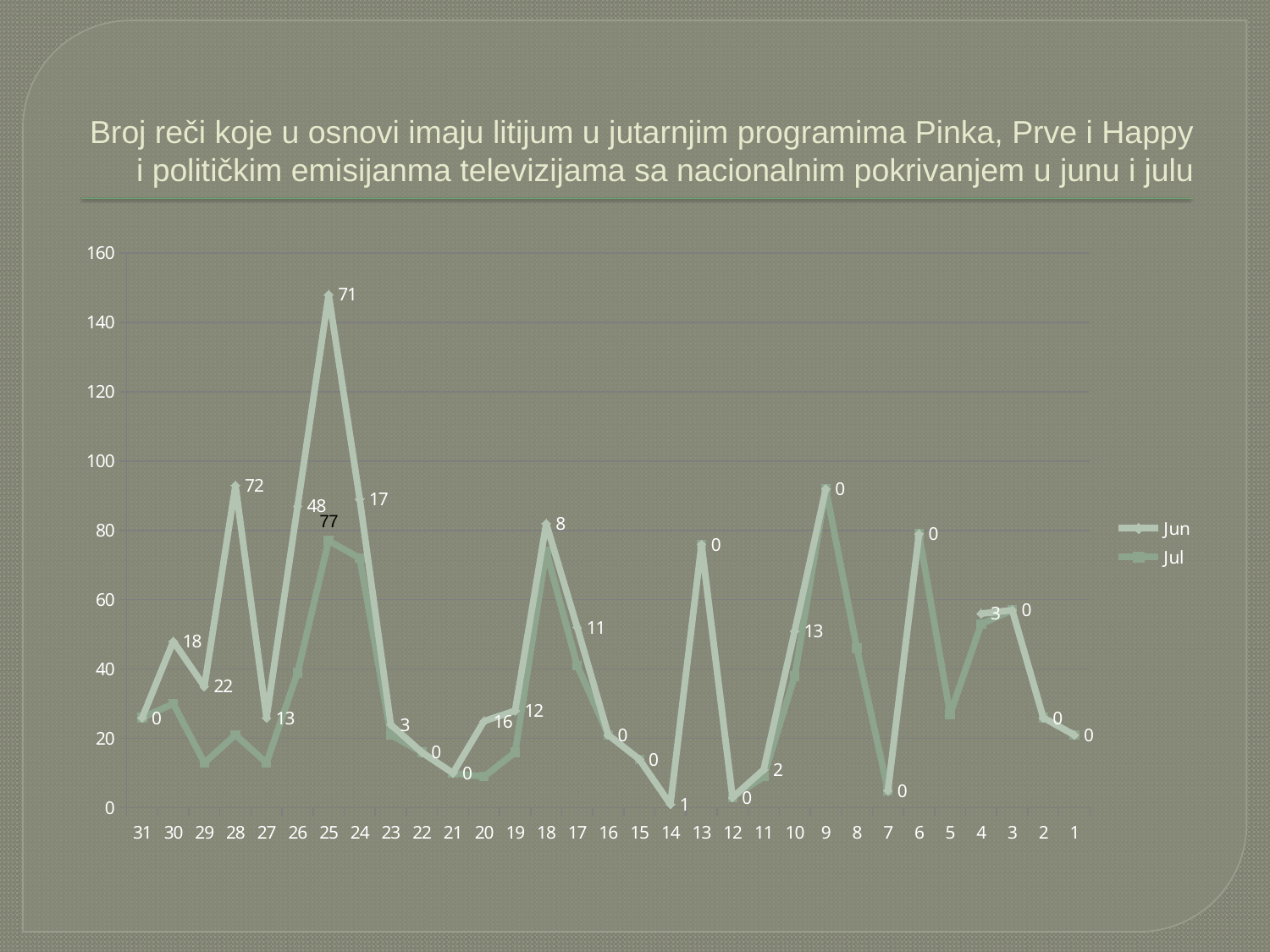
On which day does the Jun series reach its highest value? 28 On day 13, which series has the larger value, Jun or Jul? Jul Is the Jul value for day 21 greater or less than 20? less What kind of chart is shown on the slide? line chart How many categories (days) are shown along the x axis? 31 How many series does the legend list? 2 What are the two series named in the legend? Jun and Jul Is the Jun value for day 14 greater or less than 20? less Is the Jul value for day 25 greater or less than 60? greater On day 28, which series has the larger value, Jun or Jul? Jun